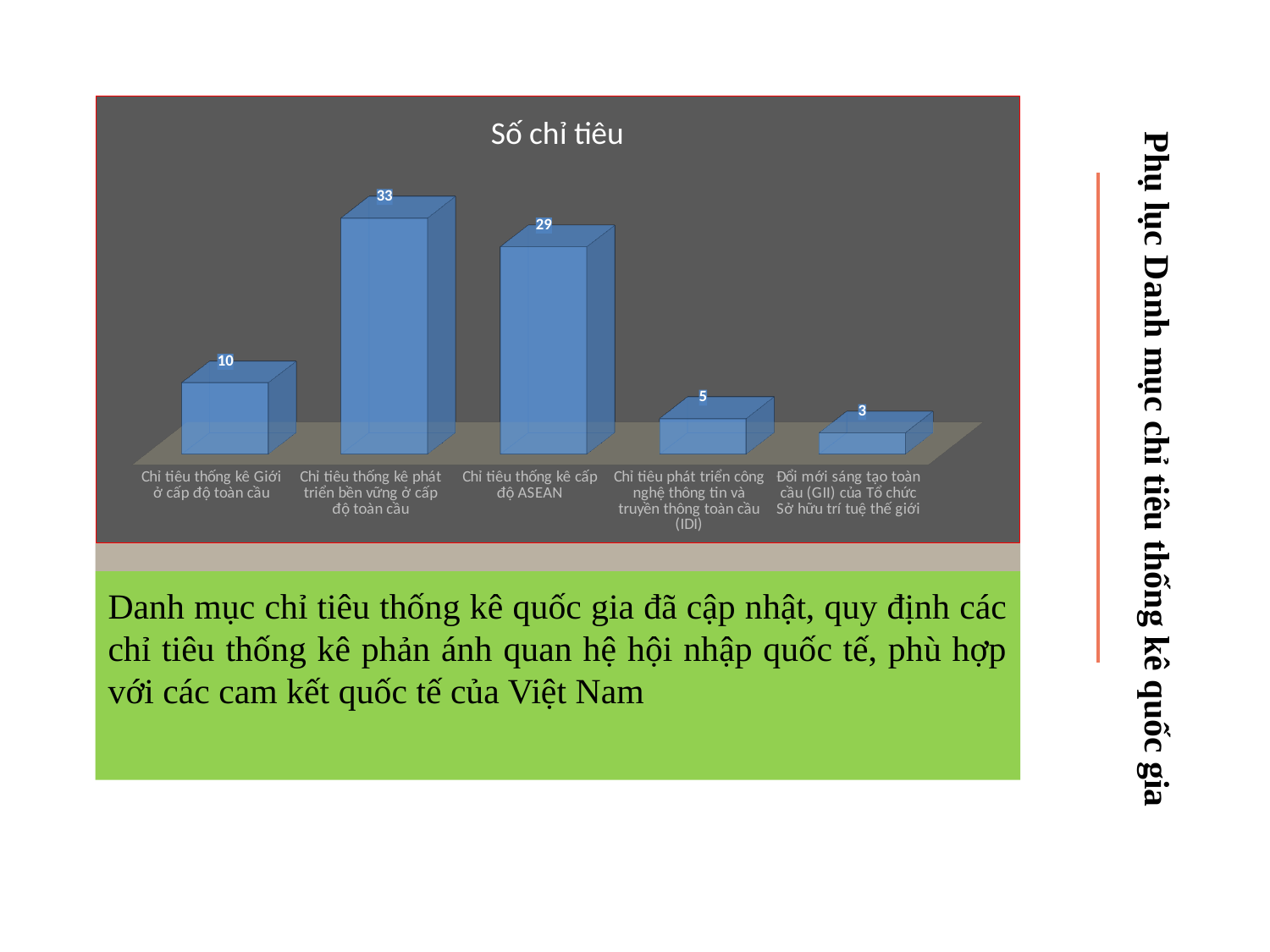
What is the value for 'Đổi mới sáng tạo toàn cầu (GII) của Tổ chức Sở hữu trí tuệ thế giới'? 3 What is the value for 'Chỉ tiêu thống kê Giới ở cấp độ toàn cầu'? 10 What is the difference between the values for 'Chỉ tiêu thống kê Giới ở cấp độ toàn cầu' and 'Chỉ tiêu phát triển công nghệ thông tin và truyền thông toàn cầu (IDI)'? 5 Which is larger: the value for 'Chỉ tiêu thống kê cấp độ ASEAN' or the value for 'Chỉ tiêu thống kê Giới ở cấp độ toàn cầu'? Chỉ tiêu thống kê cấp độ ASEAN What kind of chart is shown on the slide? Bar chart What is the value for 'Chỉ tiêu thống kê phát triển bền vững ở cấp độ toàn cầu'? 33 Which category has the highest value? Chỉ tiêu thống kê phát triển bền vững ở cấp độ toàn cầu How many categories are shown in the chart? 5 Which category has the lowest value? Đổi mới sáng tạo toàn cầu (GII) của Tổ chức Sở hữu trí tuệ thế giới What is the value for 'Chỉ tiêu thống kê cấp độ ASEAN'? 29 What is the difference between the values for 'Chỉ tiêu thống kê phát triển bền vững ở cấp độ toàn cầu' and 'Chỉ tiêu thống kê cấp độ ASEAN'? 4 What is the title of the chart? Số chỉ tiêu